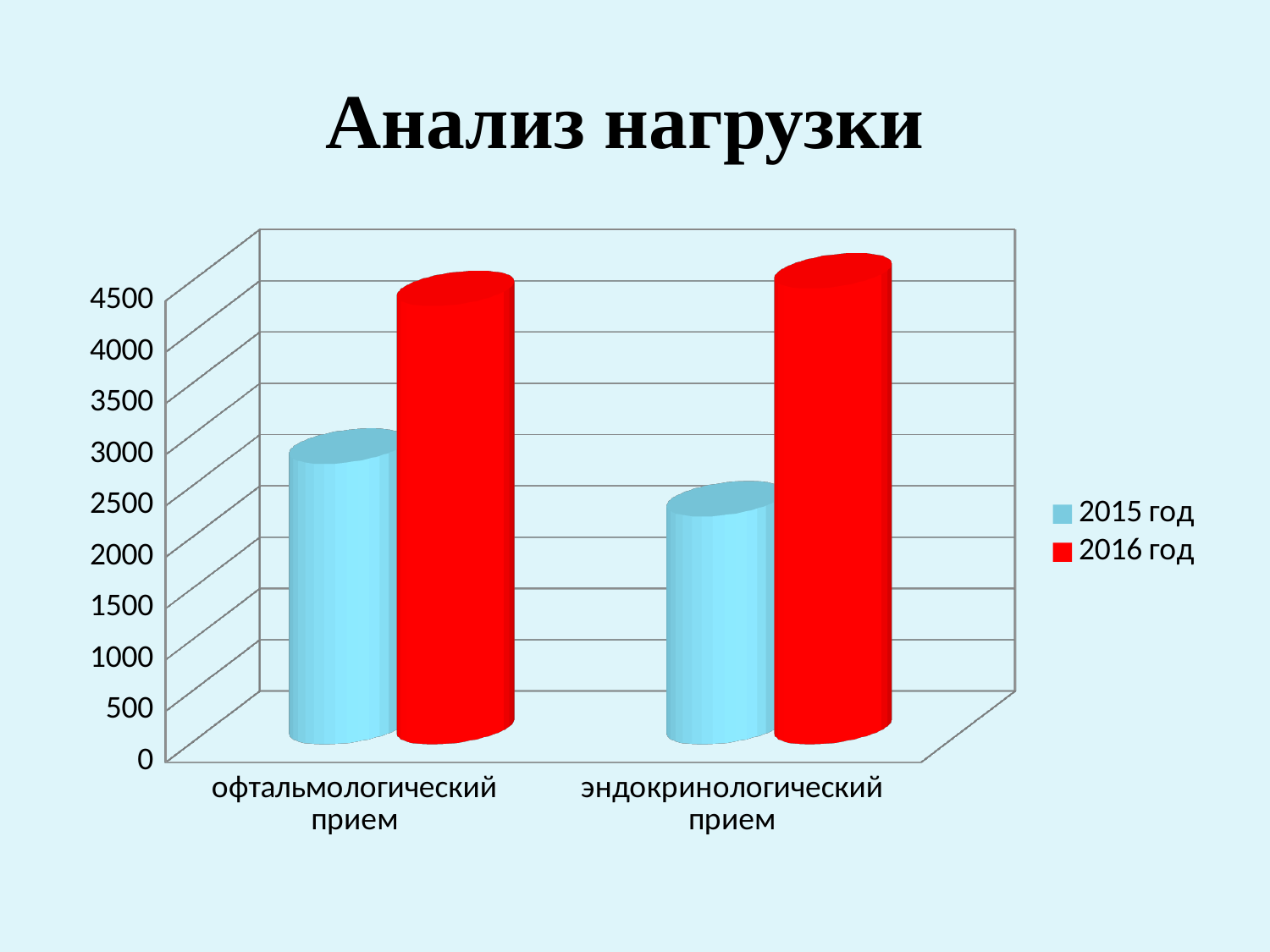
For офтальмологический прием, which year has the larger value, 2015 год or 2016 год? 2016 год What is the title of the chart? Анализ нагрузки Which series is shown in red? 2016 год Is the value for 2016 год at эндокринологический прием greater or less than 4000? greater For эндокринологический прием, which year has the larger value, 2015 год or 2016 год? 2016 год Is the value for 2015 год at офтальмологический прием greater or less than 2000? greater How many series does the legend list? 2 Which category has the lowest value for 2015 год? эндокринологический прием Is the value for 2016 год at офтальмологический прием greater or less than 4000? greater What kind of chart is shown on the slide? bar chart How many categories are shown on the x axis? 2